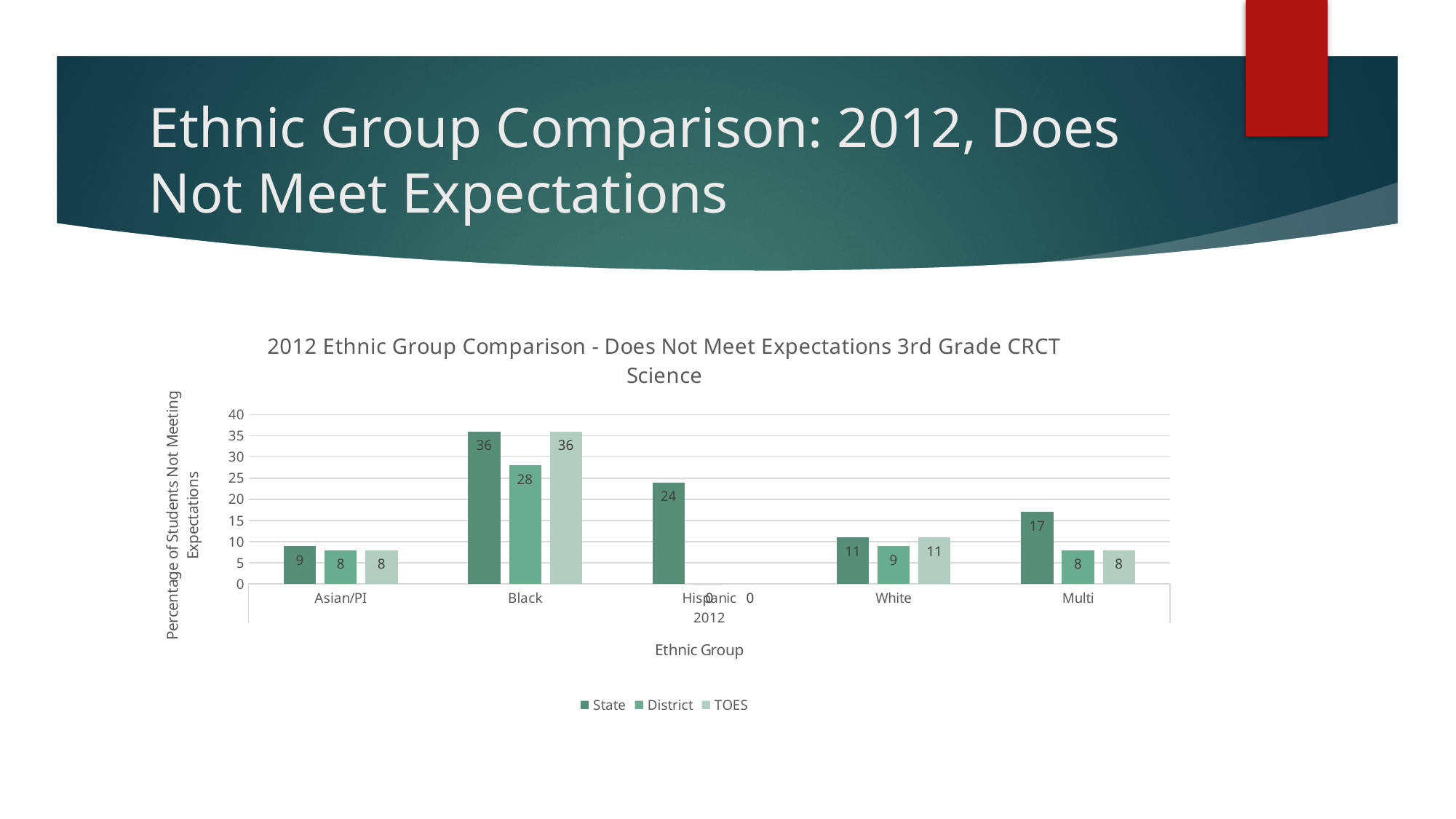
Which ethnic group has the highest State value? Black What is the label of the y axis? Percentage of Students Not Meeting Expectations How many series does the legend list? 3 What is the District value for Black? 28 What type of chart is shown on the slide? bar chart What is the difference between the State value and the District value for Multi? 9 What is the State value for Hispanic? 24 What is the TOES value for White? 11 Which ethnic group has the lowest District value? Hispanic What is the State value for Black? 36 Which is larger, the State value for Multi or the State value for White? State value for Multi How many ethnic group categories are shown on the x axis? 5